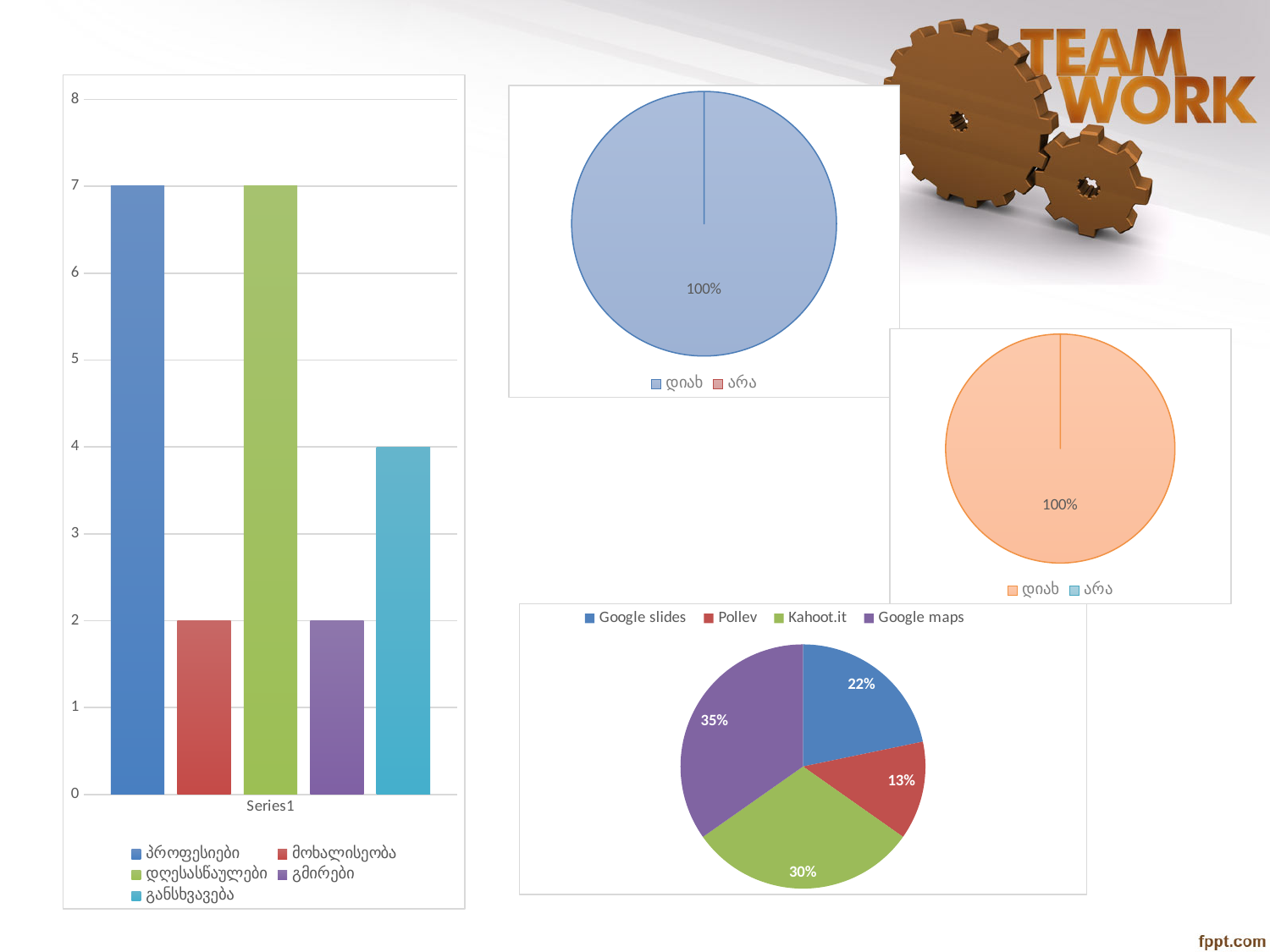
In the bar chart on the left, what is the value for მოხალისეობა? 2 In the top-middle pie chart, what percentage is shown for დიახ? 100% In the bar chart on the left, how many series does the legend list? 5 In the bottom pie chart with the Google slides legend, what share does Pollev have? 13% In the bar chart on the left, what is the value for განსხვავება? 4 In the bottom pie chart with the Google slides legend, how many slices are there? 4 In the bottom pie chart with the Google slides legend, which slice is the largest? Google maps In the bar chart on the left, which is larger, განსხვავება or გმირები? განსხვავება In the bar chart on the left, what is the difference between the values for პროფესიები and განსხვავება? 3 In the bar chart on the left, what is the value for პროფესიები? 7 What kind of chart is the chart on the left of the slide? bar chart In the bottom pie chart with the Google slides legend, what share does Google maps have? 35%